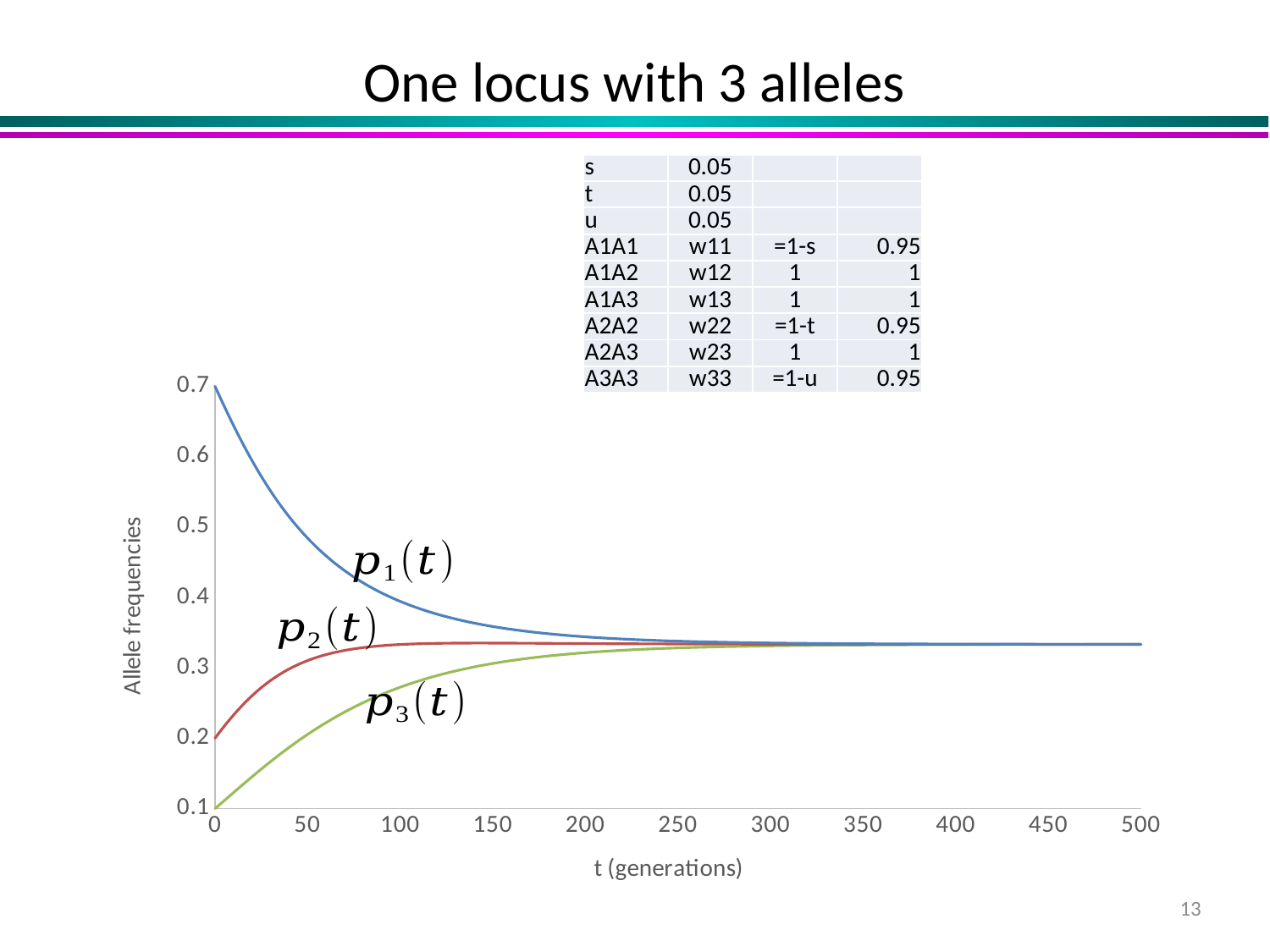
What is the value of p1(t) at t = 0? 0.7 Does p1(t) rise or fall as t increases? fall How many curves (series) are plotted on the chart? 3 Is the value of p1(t) at t = 50 greater or less than 0.4? greater Does p3(t) rise or fall as t increases? rise What is the difference between p1(t) and p3(t) at t = 0? 0.6 What is the label of the x axis? t (generations) What is the value of p3(t) at t = 0? 0.1 What is the value of p2(t) at t = 0? 0.2 Which curve has the highest value at t = 0? p1(t) What kind of chart is shown on the slide? line chart Which curve has the lowest value at t = 0? p3(t)